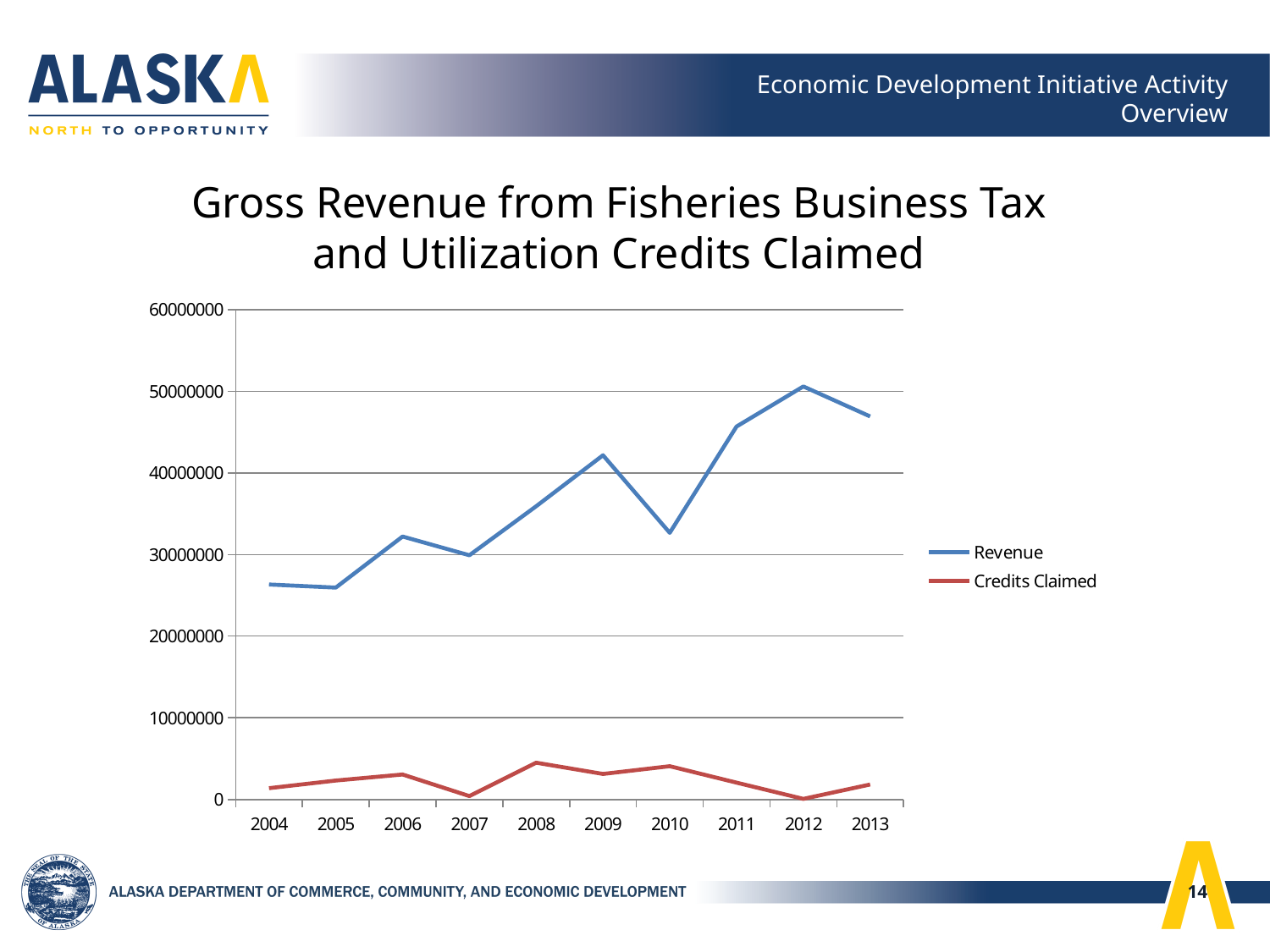
Which year has the larger Revenue, 2012 or 2013? 2012 Is the Credits Claimed value for 2008 greater or less than 10000000? less What colour is the Revenue line? Blue Is the Revenue value for 2004 greater or less than 30000000? less How many years are plotted along the x axis? 10 In which year is Revenue highest? 2012 What kind of chart is shown on the slide? Line chart Is the Revenue value for 2010 greater or less than 40000000? less Does Revenue rise or fall from 2010 to 2012? Rise Which year has the larger Revenue, 2009 or 2010? 2009 How many series does the legend list? 2